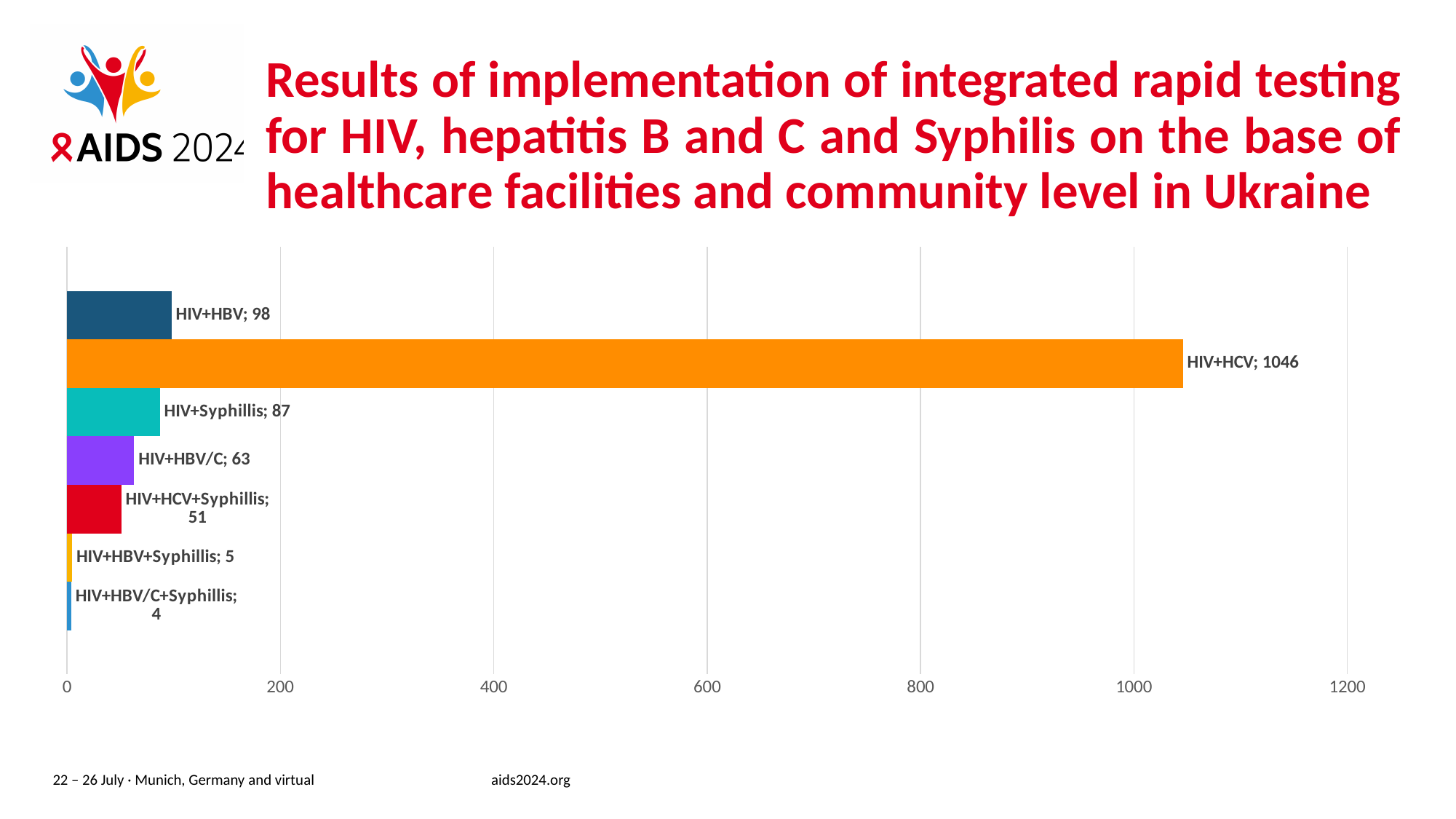
How many categories are shown in the chart? 7 Which category has the lowest value? HIV+HBV/C+Syphillis What is the difference between the values for HIV+HBV and HIV+Syphillis? 11 What is the difference between the values for HIV+HCV and HIV+HBV? 948 What kind of chart is shown on the slide? Bar chart Which is larger, the value for HIV+HBV/C or the value for HIV+HCV+Syphillis? HIV+HBV/C What is the value for HIV+Syphillis? 87 What is the value for HIV+HCV+Syphillis? 51 What is the value for HIV+HBV? 98 Which category has the highest value? HIV+HCV Is the value for HIV+HCV greater or less than 1000? greater What is the value for HIV+HCV? 1046